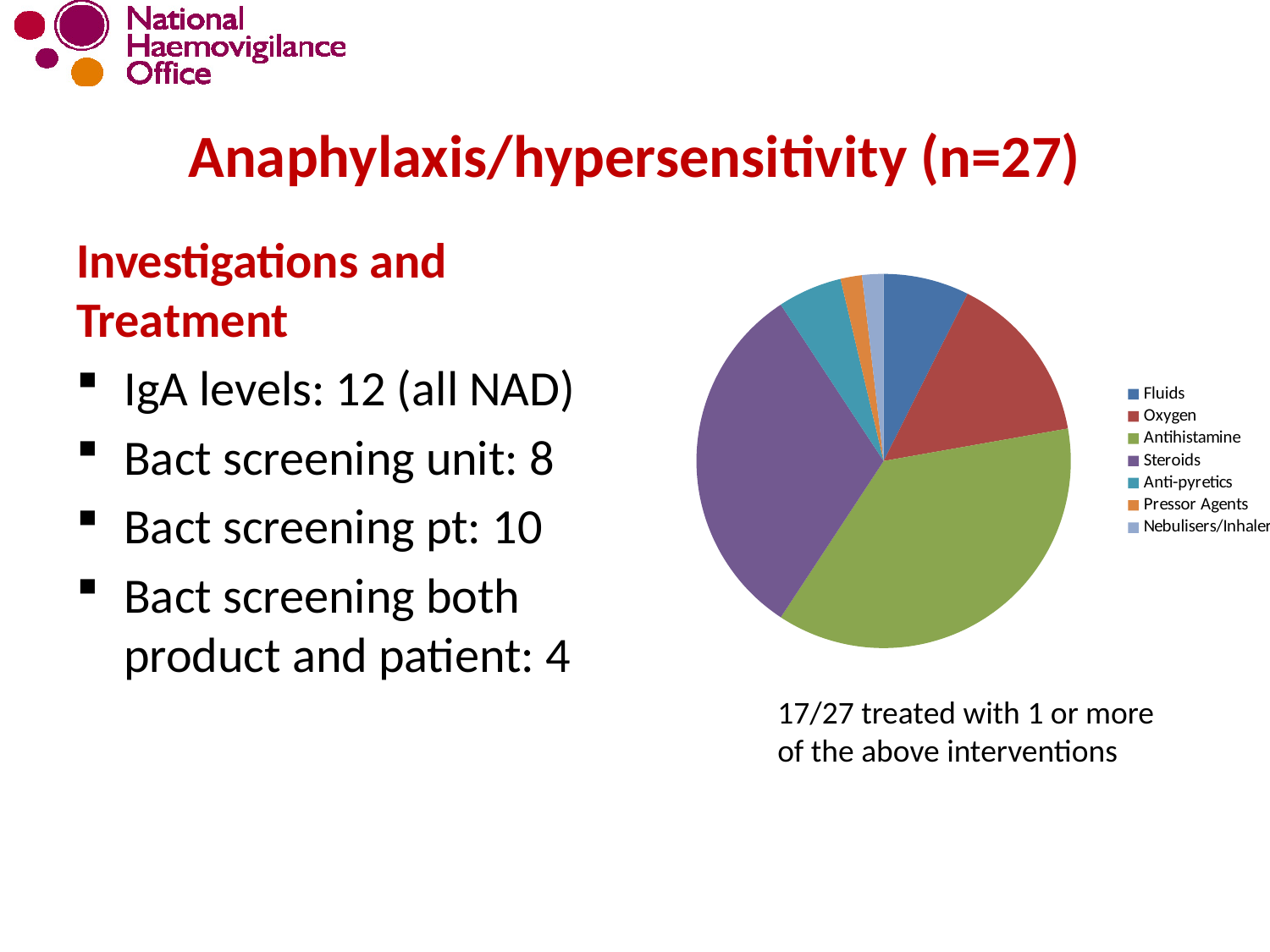
How many categories does the pie chart's legend list? 7 What colour is the Antihistamine slice in the pie chart? Green Which legend entry is listed first in the pie chart's legend? Fluids Which slice is larger in the pie chart, Oxygen or Fluids? Oxygen Which slice is larger in the pie chart, Steroids or Pressor Agents? Steroids What kind of chart is shown on the slide? Pie chart Which slice is larger in the pie chart, Steroids or Oxygen? Steroids Which category has the largest slice of the pie chart? Antihistamine